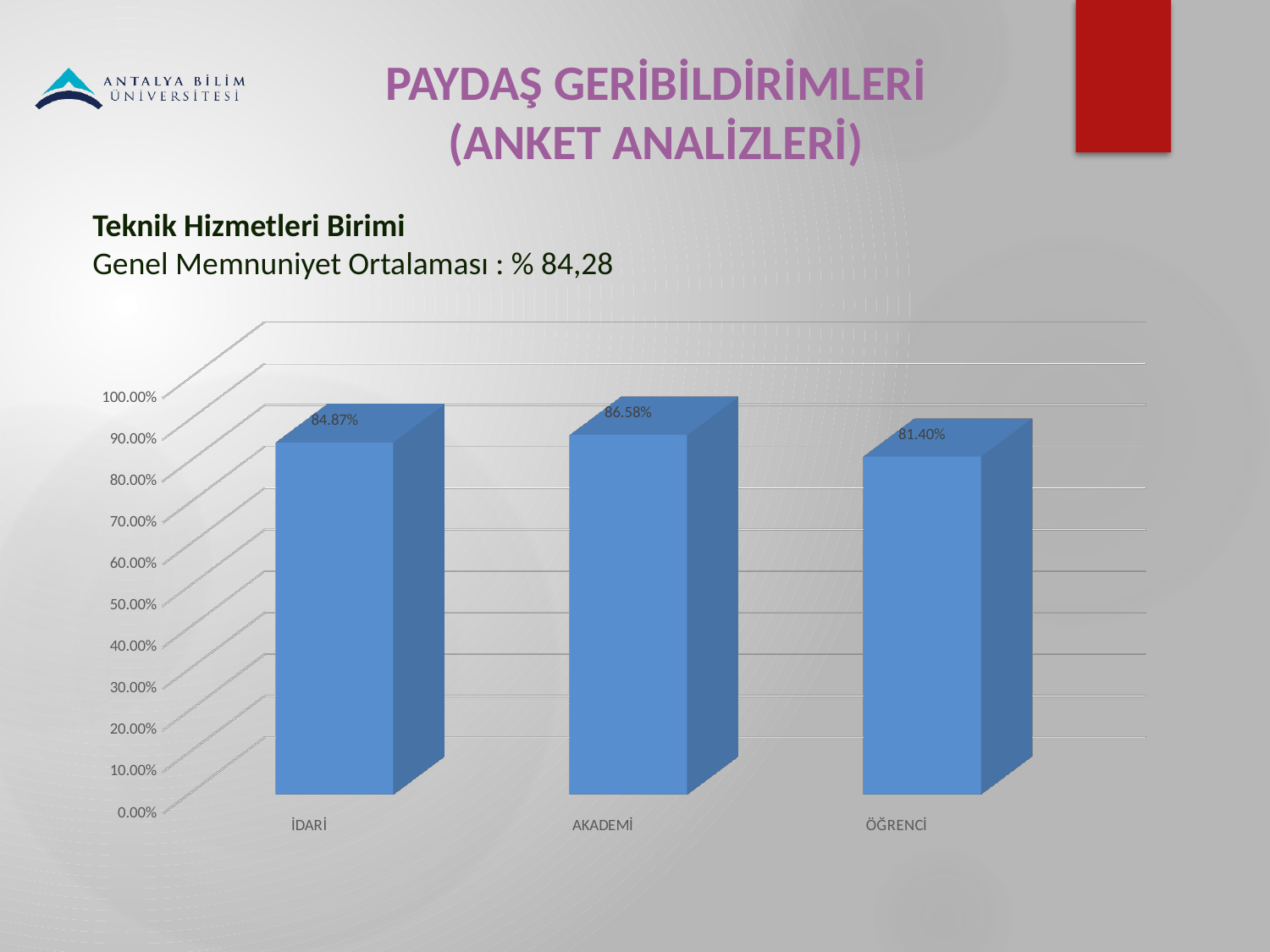
What is the Genel Memnuniyet Ortalaması stated above the chart? % 84,28 What kind of chart is shown on the slide? bar chart What is the value for AKADEMİ? 86.58% Which is larger, the value for İDARİ or the value for AKADEMİ? AKADEMİ Is the value for ÖĞRENCİ greater or less than 90.00%? less Which category has the highest value? AKADEMİ What is the value for İDARİ? 84.87% Which category has the lowest value? ÖĞRENCİ What is the value for ÖĞRENCİ? 81.40% How many categories are shown on the chart? 3 What is the difference between the values for İDARİ and ÖĞRENCİ? 3.47% What is the difference between the values for AKADEMİ and ÖĞRENCİ? 5.18%